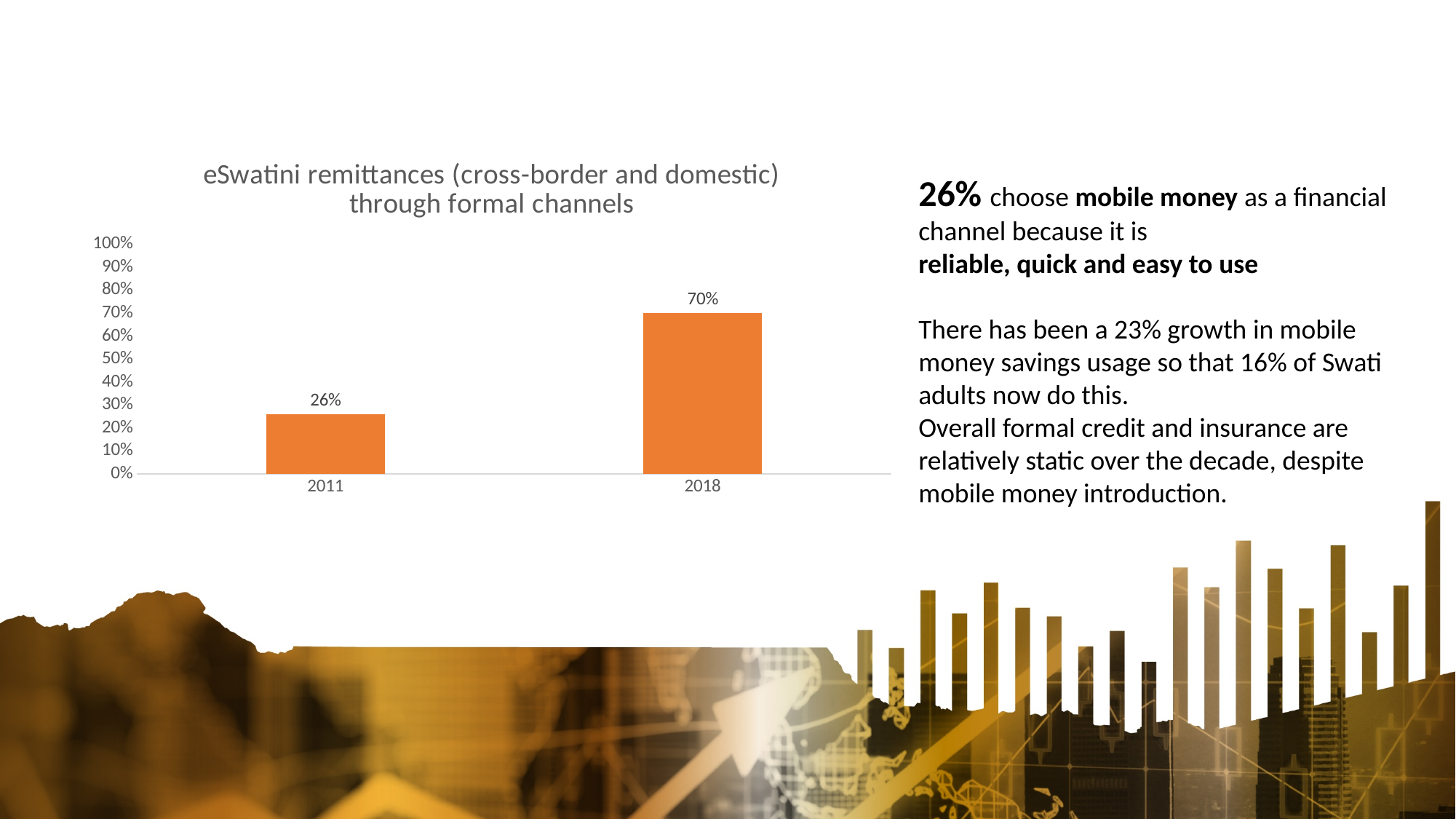
Which year has the highest value in the chart? 2018 What is the value for 2018 in the chart? 70% Which is larger, the value for 2011 or the value for 2018? 2018 Is the value for 2011 greater or less than 30%? less What is the difference between the 2018 and 2011 values? 44% What is the value for 2011 in the chart? 26% What is the title of the chart? eSwatini remittances (cross-border and domestic) through formal channels What kind of chart is shown on the slide? Bar chart Which year has the lowest value in the chart? 2011 Is the value for 2018 greater or less than 50%? greater Do the values rise or fall from 2011 to 2018? Rise How many bars are shown in the chart? 2